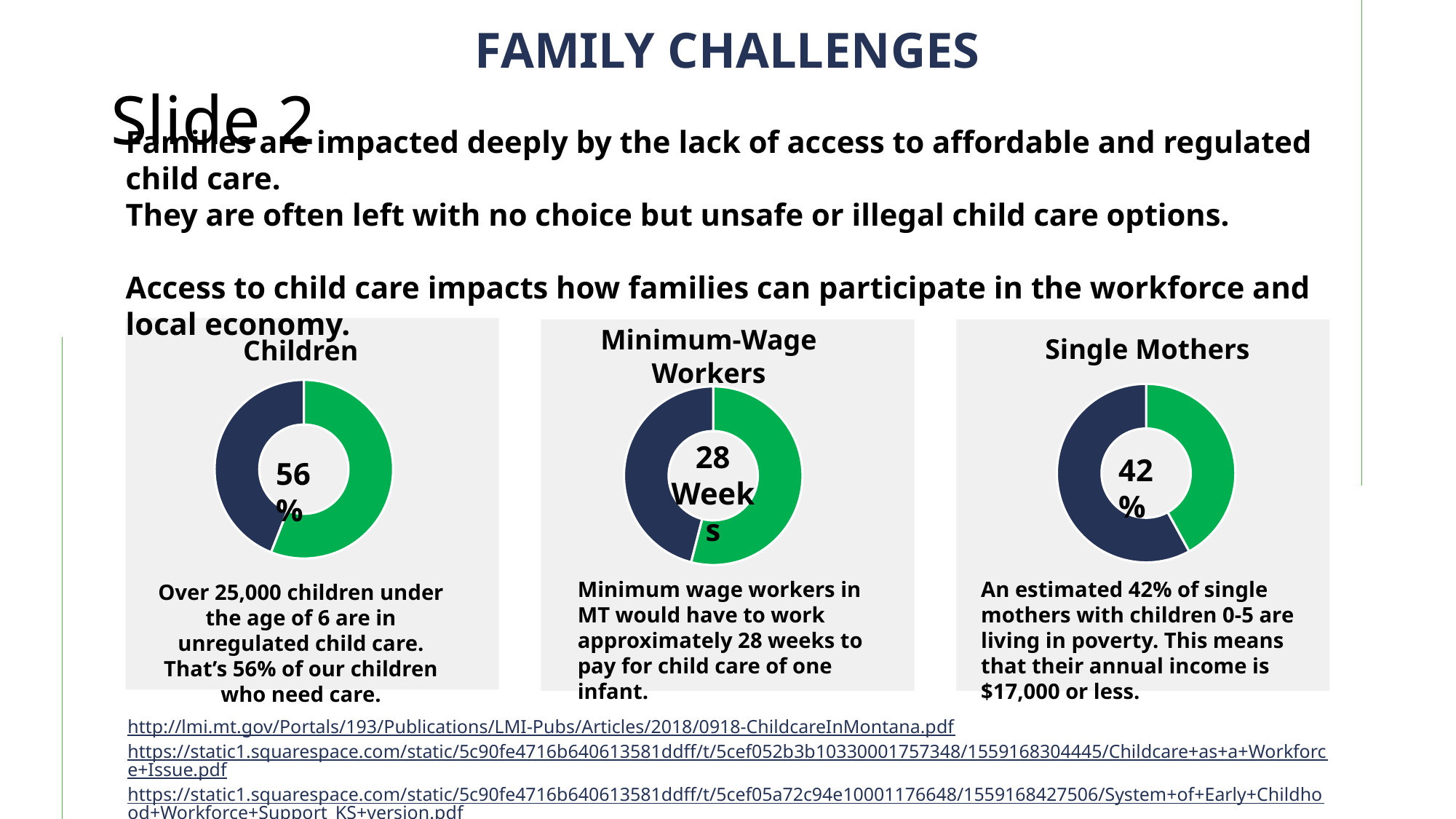
What value is shown in the centre of the 'Single Mothers' donut chart? 42% What is the title of the middle donut chart on the slide? Minimum-Wage Workers Is the percentage shown in the 'Single Mothers' donut chart greater or less than 50%? less Is the percentage shown in the 'Children' donut chart greater or less than 50%? greater What kind of chart is used for the 'Children', 'Minimum-Wage Workers' and 'Single Mothers' figures? Donut (pie) chart What is the difference between the percentage shown in the 'Children' chart and the percentage shown in the 'Single Mothers' chart? 14 percentage points Which is larger, the percentage in the 'Children' chart or the percentage in the 'Single Mothers' chart? Children (56%) What value is shown in the centre of the 'Children' donut chart? 56% What two colours are used for the slices in the donut charts? Green and dark navy blue How many slices does the 'Children' donut chart have? 2 How many donut charts are shown on the slide? 3 What value is shown in the centre of the 'Minimum-Wage Workers' donut chart? 28 Weeks